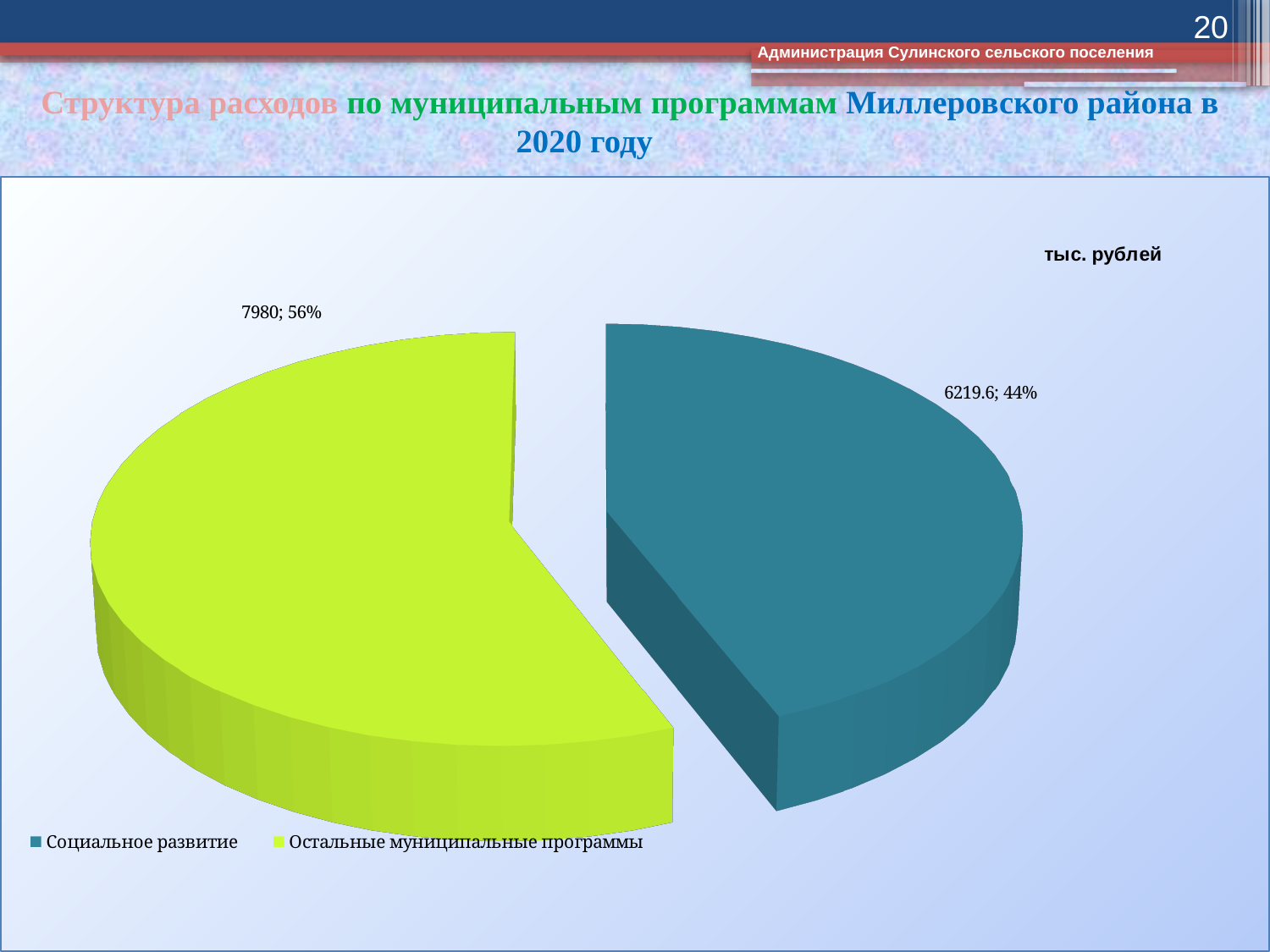
Which category has the smallest slice? Социальное развитие What unit is indicated for the chart values? тыс. рублей What share of the pie does Остальные муниципальные программы represent? 56% What share of the pie does Социальное развитие represent? 44% Which is larger: Социальное развитие or Остальные муниципальные программы? Остальные муниципальные программы What kind of chart is shown on the slide? pie chart What is the value for Социальное развитие? 6219.6 What is the difference between the values for Остальные муниципальные программы and Социальное развитие? 1760.4 What is the value for Остальные муниципальные программы? 7980 Which category has the largest slice? Остальные муниципальные программы What colour is the slice for Социальное развитие? teal blue How many slices does the pie chart have? 2